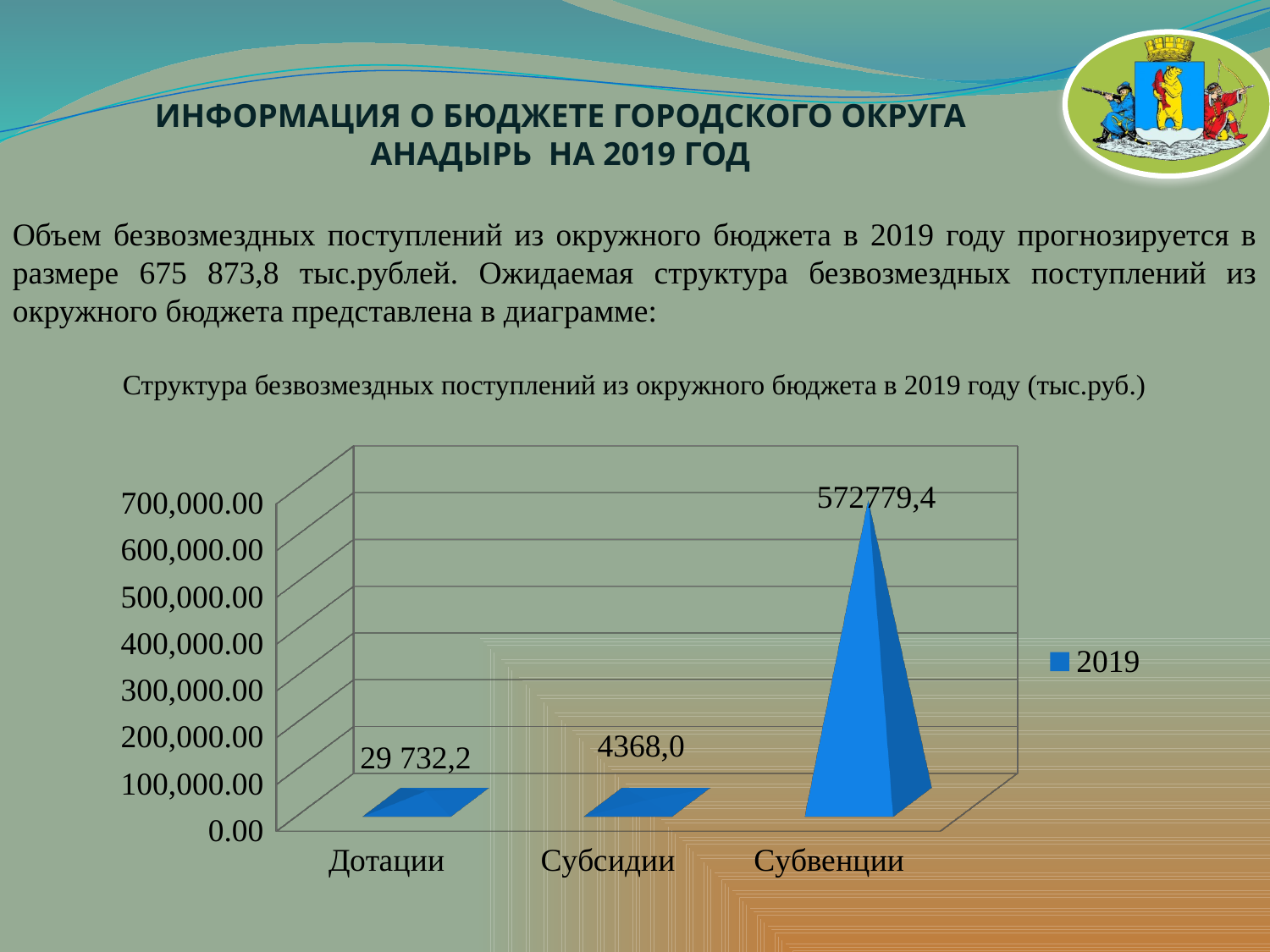
Which is larger, Дотации or Субсидии? Дотации How many series does the legend list? 1 Is the value for Субвенции greater or less than 500,000.00? greater How many categories are shown on the x axis? 3 What is the difference between the values for Субвенции and Дотации? 543047,2 What is the value for Субсидии? 4368,0 Which category has the highest value? Субвенции What is the value for Дотации? 29 732,2 What is the title of the chart? Структура безвозмездных поступлений из окружного бюджета в 2019 году (тыс.руб.) Is the value for Дотации greater or less than 100,000.00? less Which category has the lowest value? Субсидии What is the value for Субвенции? 572779,4